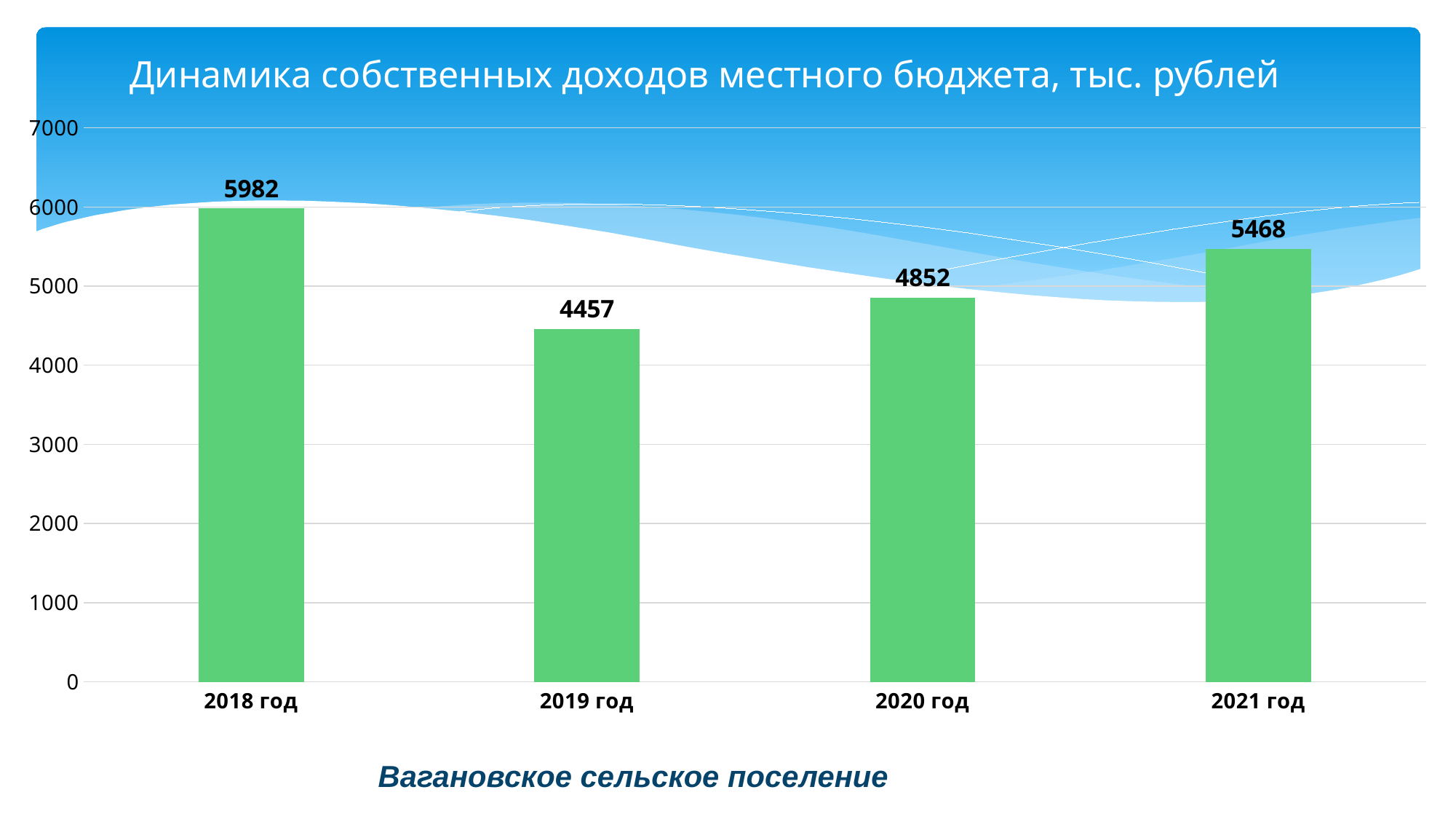
Which is larger, the value for 2020 год or the value for 2021 год? 2021 год Which year has the highest value? 2018 год What is the value for 2018 год? 5982 What is the value for 2021 год? 5468 What is the value for 2020 год? 4852 What is the difference between the values for 2021 год and 2020 год? 616 What kind of chart is this? bar chart Which year has the lowest value? 2019 год What is the value for 2019 год? 4457 What is the difference between the values for 2018 год and 2019 год? 1525 What is the title of the chart? Динамика собственных доходов местного бюджета, тыс. рублей How many years are shown on the chart? 4